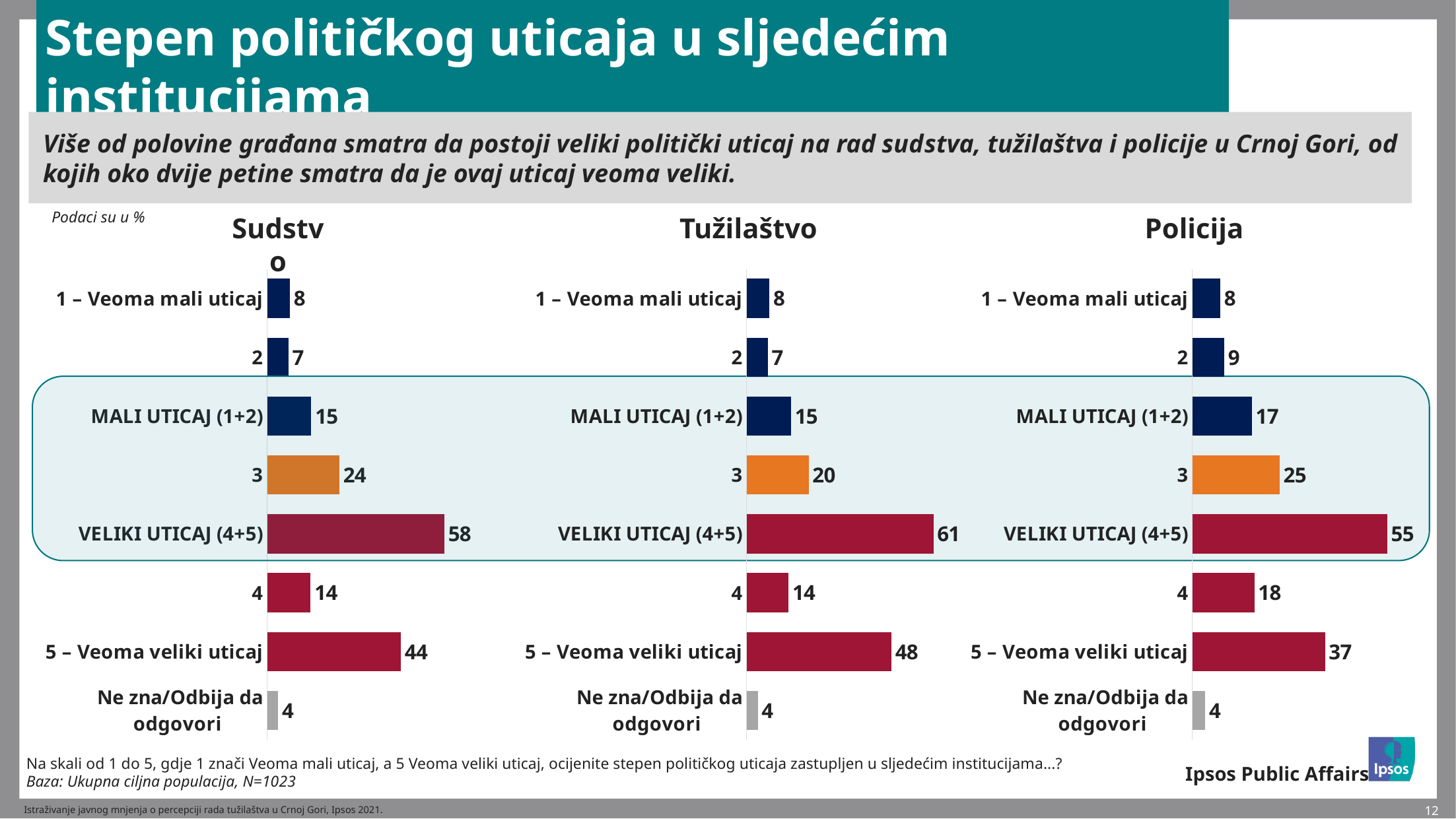
In the Sudstvo chart, what is the difference between the values for 5 – Veoma veliki uticaj and 4? 30 In the Sudstvo chart, how many categories are shown? 8 What colour is the bar for 3 in the Tužilaštvo chart? Orange In the Policija chart, what is the value for MALI UTICAJ (1+2)? 17 In the Sudstvo chart, what is the value for VELIKI UTICAJ (4+5)? 58 In the Sudstvo chart, which category has the lowest value? Ne zna/Odbija da odgovori What type of chart is the Policija chart? Bar chart In the Tužilaštvo chart, what is the value for 5 – Veoma veliki uticaj? 48 In the Policija chart, what is the difference between the values for VELIKI UTICAJ (4+5) and MALI UTICAJ (1+2)? 38 Which is larger: the value for 5 – Veoma veliki uticaj in the Tužilaštvo chart or in the Policija chart? Tužilaštvo In the Tužilaštvo chart, which category has the highest value? VELIKI UTICAJ (4+5) In the Policija chart, what is the value for 3? 25